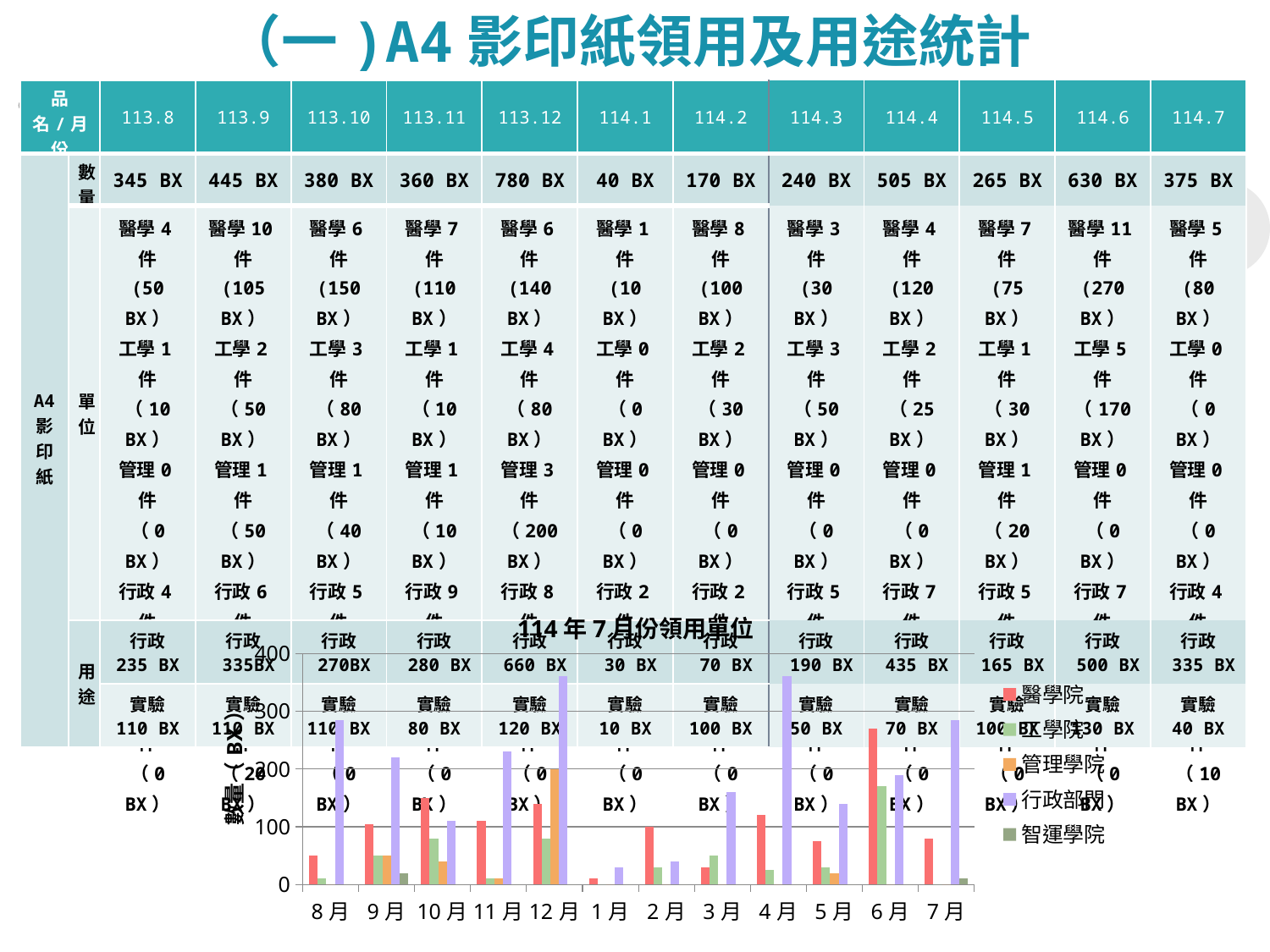
Is the value for 行政部門 in 4月 greater or less than 300? greater What kind of chart is shown on the slide? bar chart Which is larger: the value for 醫學院 in 6月 or the value for 醫學院 in 8月? 6月 What is the title of the chart? 114年7月份領用單位 Is the value for 行政部門 in 12月 greater or less than 300? greater Is the value for 醫學院 in 8月 greater or less than 100? less How many month categories are shown on the chart's x axis? 12 What is the label of the chart's y axis? 數量（BX） Which is larger: the value for 行政部門 in 12月 or the value for 行政部門 in 1月? 12月 How many series does the chart's legend list? 5